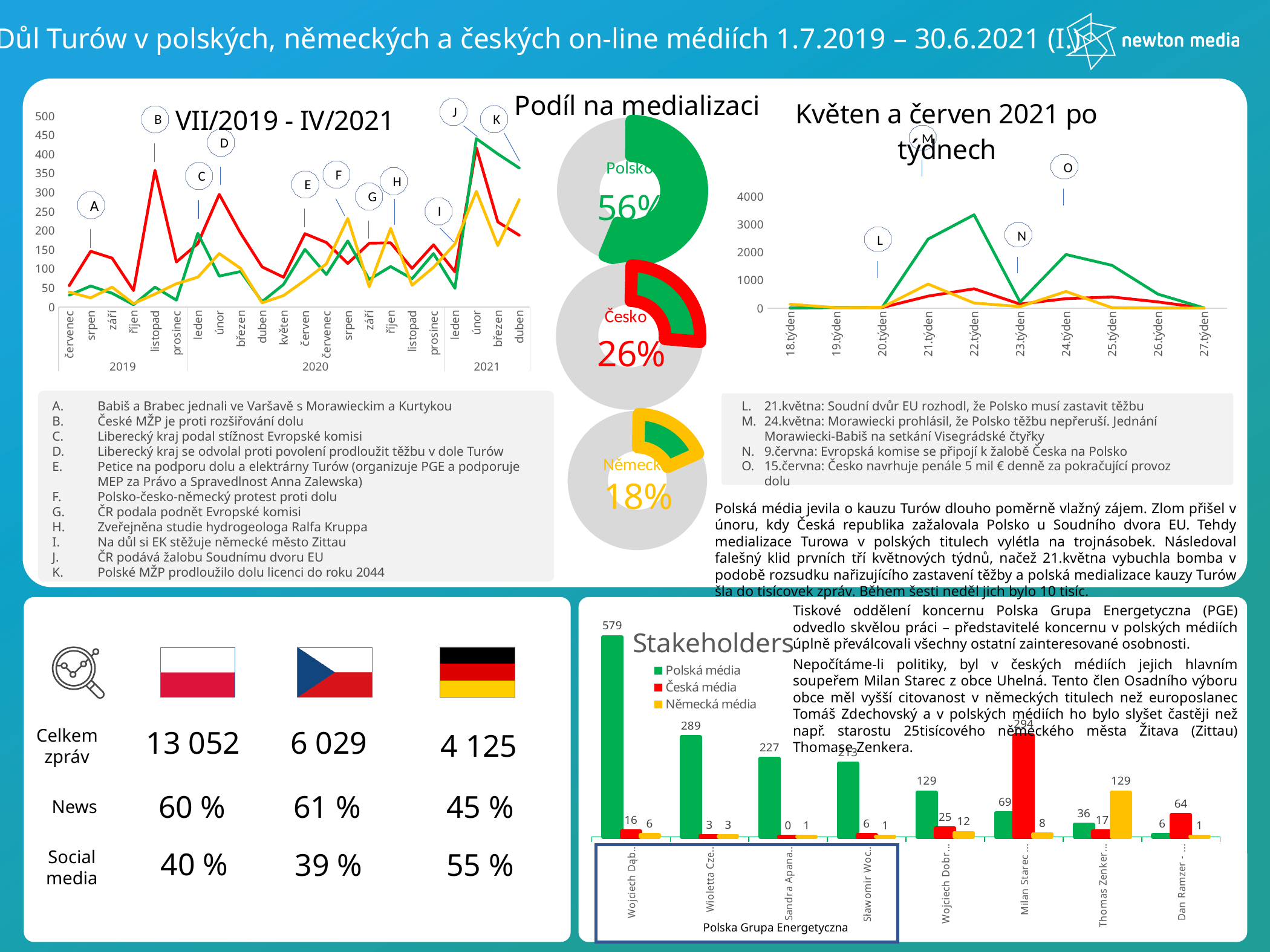
What kind of chart is the Stakeholders chart? bar chart In the Stakeholders bar chart, which stakeholder has the highest Polská média value? Wojciech Dąb... In the Stakeholders bar chart, what is the difference between the Polská média values for Wojciech Dąb... and Wioletta Cze...? 290 In the Stakeholders bar chart, what is the value for Milan Starec... in the Česká média series? 294 In the Podíl na medializaci donut charts, what share does Polsko have? 56% In the Podíl na medializaci donut charts, which country has the lowest share? Německo In the Stakeholders bar chart, what is the value for Thomas Zenker... in the Německá média series? 129 In the chart 'Květen a červen 2021 po týdnech', how many weeks are shown on the x axis? 10 In the Stakeholders bar chart, how many series does the legend list? 3 In the chart 'Květen a červen 2021 po týdnech', is the value of the green line at 22.týden greater or less than 3000? greater In the Stakeholders bar chart, how many stakeholders are shown on the x axis? 8 In the Stakeholders bar chart, what is the value for Wojciech Dąb... in the Polská média series? 579